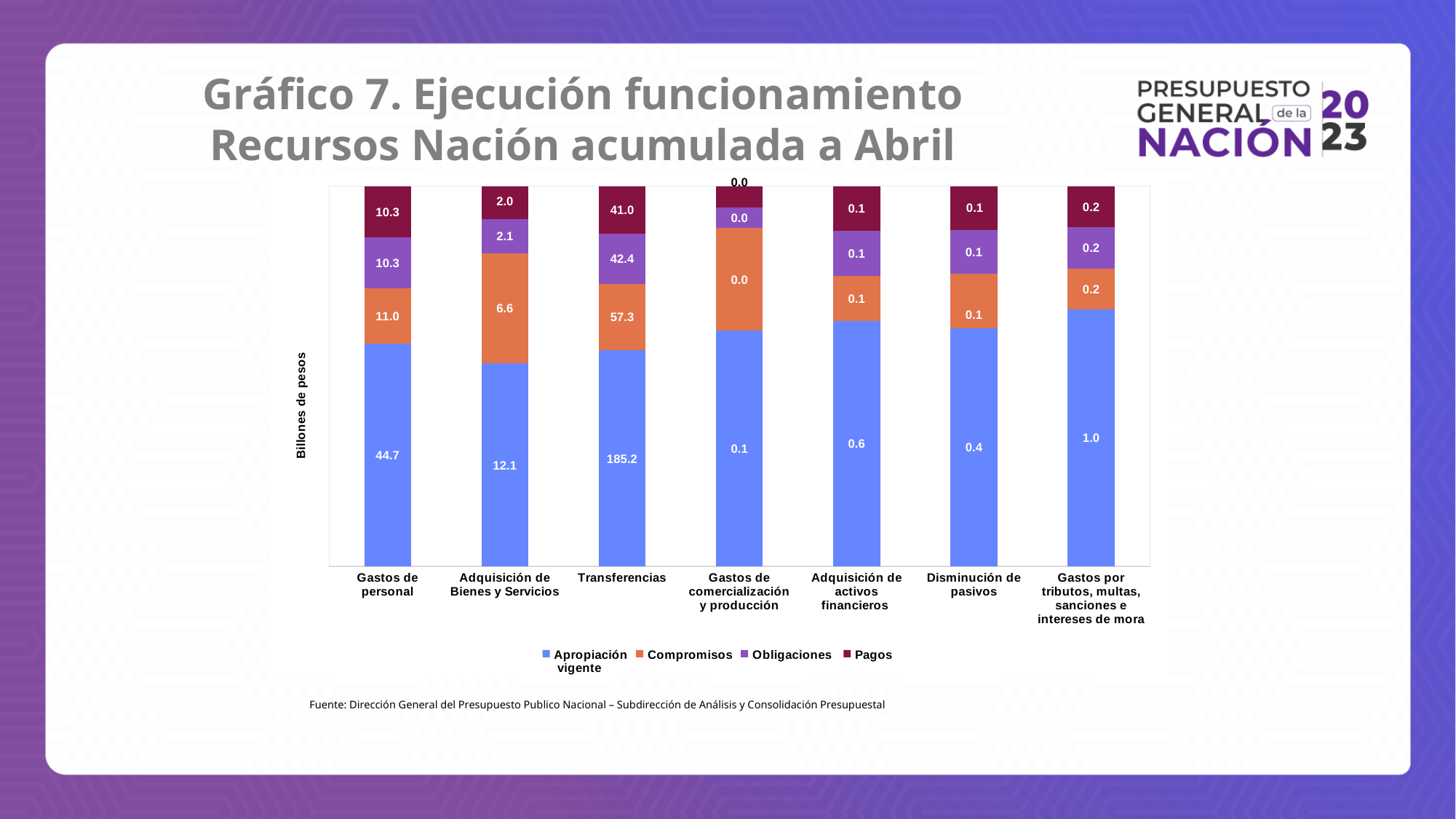
What is the Compromisos value for Gastos de personal? 11.0 What is the label on the vertical axis? Billones de pesos What is the difference between the Compromisos value for Transferencias and the Compromisos value for Gastos de personal? 46.3 What is the Apropiación vigente value for Transferencias? 185.2 What kind of chart is shown on the slide? Stacked bar chart How many series does the legend list? 4 Which is larger: the Apropiación vigente value for Gastos de personal or for Adquisición de Bienes y Servicios? Gastos de personal Which category has the highest Apropiación vigente value? Transferencias What is the Pagos value for Adquisición de Bienes y Servicios? 2.0 What is the Obligaciones value for Transferencias? 42.4 Which category has the lowest Apropiación vigente value? Gastos de comercialización y producción How many categories are shown on the x axis? 7